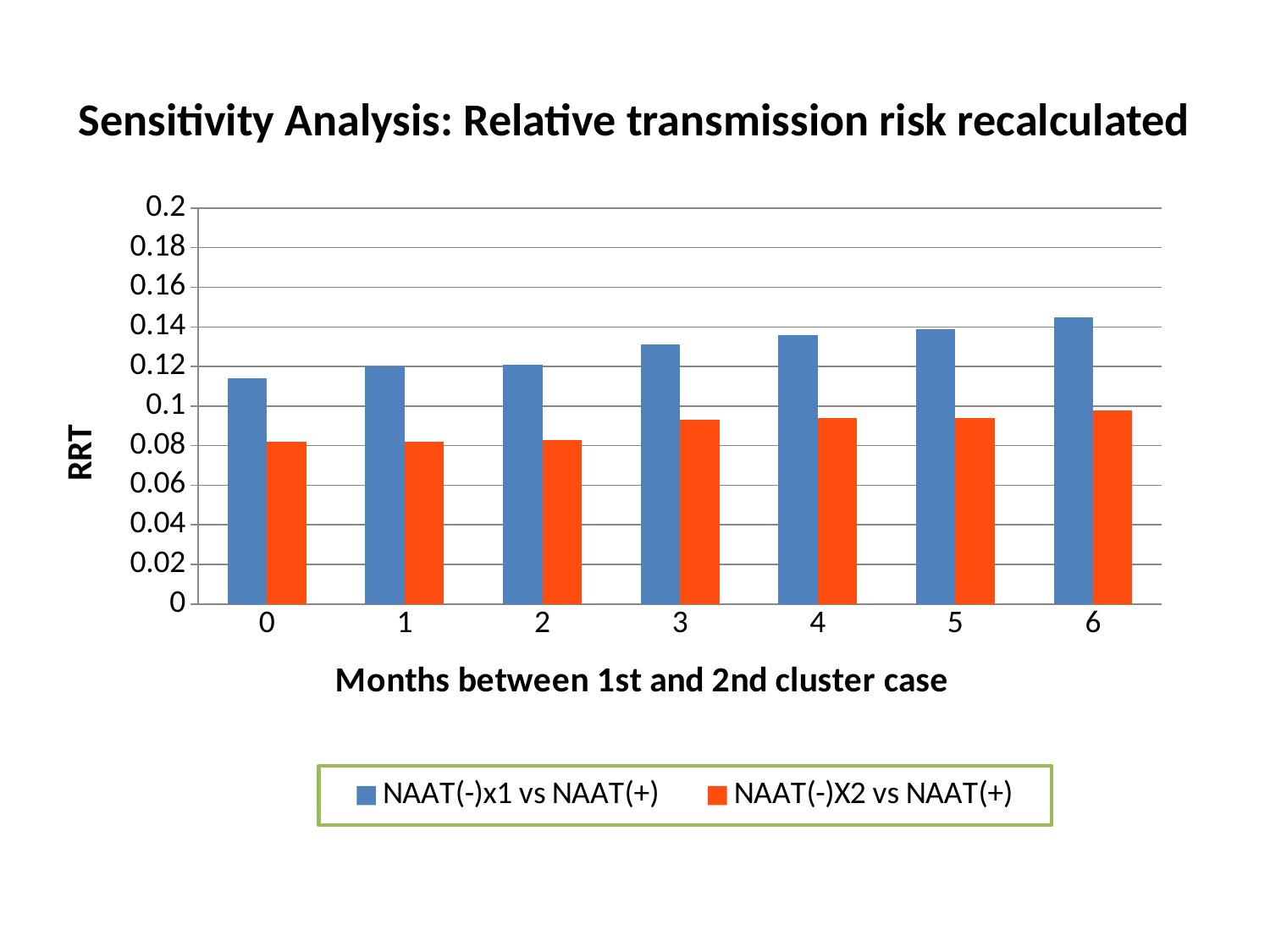
Is the value for NAAT(-)x1 vs NAAT(+) at month 0 greater or less than 0.1? greater Which month has the lowest value for NAAT(-)x1 vs NAAT(+)? 0 Which month has the highest value for NAAT(-)x1 vs NAAT(+)? 6 Is the value for NAAT(-)X2 vs NAAT(+) at month 3 greater or less than 0.1? less Is the value for NAAT(-)x1 vs NAAT(+) at month 3 greater or less than 0.12? greater How many series does the legend list? 2 What type of chart is shown on the slide? bar chart Do the values for NAAT(-)x1 vs NAAT(+) generally rise or fall as the months increase? rise At month 4, which series has the larger value, NAAT(-)x1 vs NAAT(+) or NAAT(-)X2 vs NAAT(+)? NAAT(-)x1 vs NAAT(+) What is the label of the y axis? RRT Which month has the highest value for NAAT(-)X2 vs NAAT(+)? 6 How many month categories are shown on the x axis? 7